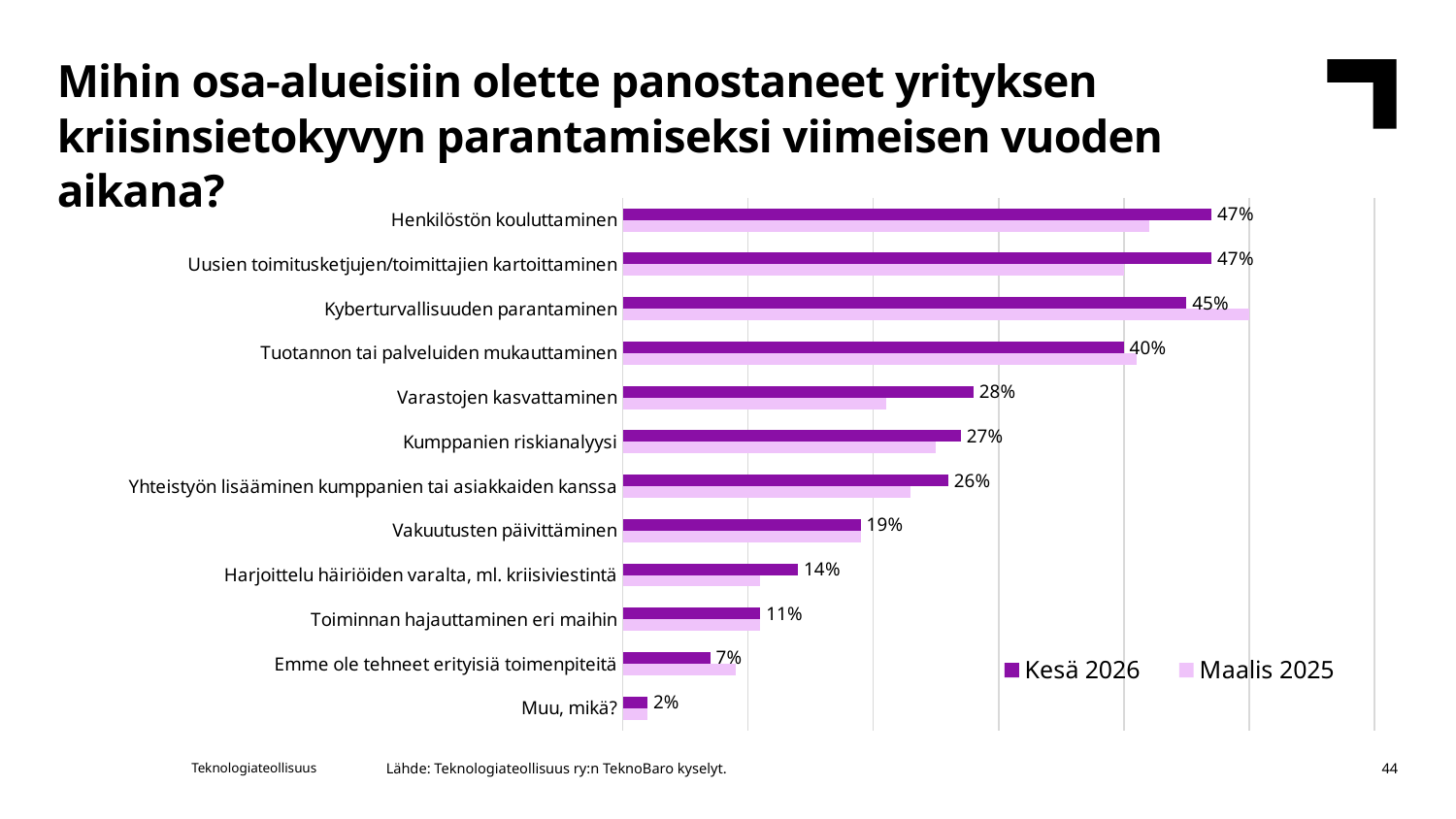
What is the difference between the Kesä 2026 values for Tuotannon tai palveluiden mukauttaminen and Varastojen kasvattaminen? 12% How many categories are shown in the chart? 12 Which has the larger Kesä 2026 value: Kumppanien riskianalyysi or Vakuutusten päivittäminen? Kumppanien riskianalyysi For Kyberturvallisuuden parantaminen, which series has the longer bar: Kesä 2026 or Maalis 2025? Maalis 2025 What is the Kesä 2026 value for Emme ole tehneet erityisiä toimenpiteitä? 7% What is the Kesä 2026 value for Varastojen kasvattaminen? 28% How many series does the legend list? 2 Which category has the lowest Kesä 2026 value? Muu, mikä? What kind of chart is shown on the slide? Bar chart What is the Kesä 2026 value for Vakuutusten päivittäminen? 19% What is the difference between the Kesä 2026 values for Harjoittelu häiriöiden varalta, ml. kriisiviestintä and Toiminnan hajauttaminen eri maihin? 3% What is the Kesä 2026 value for Kyberturvallisuuden parantaminen? 45%